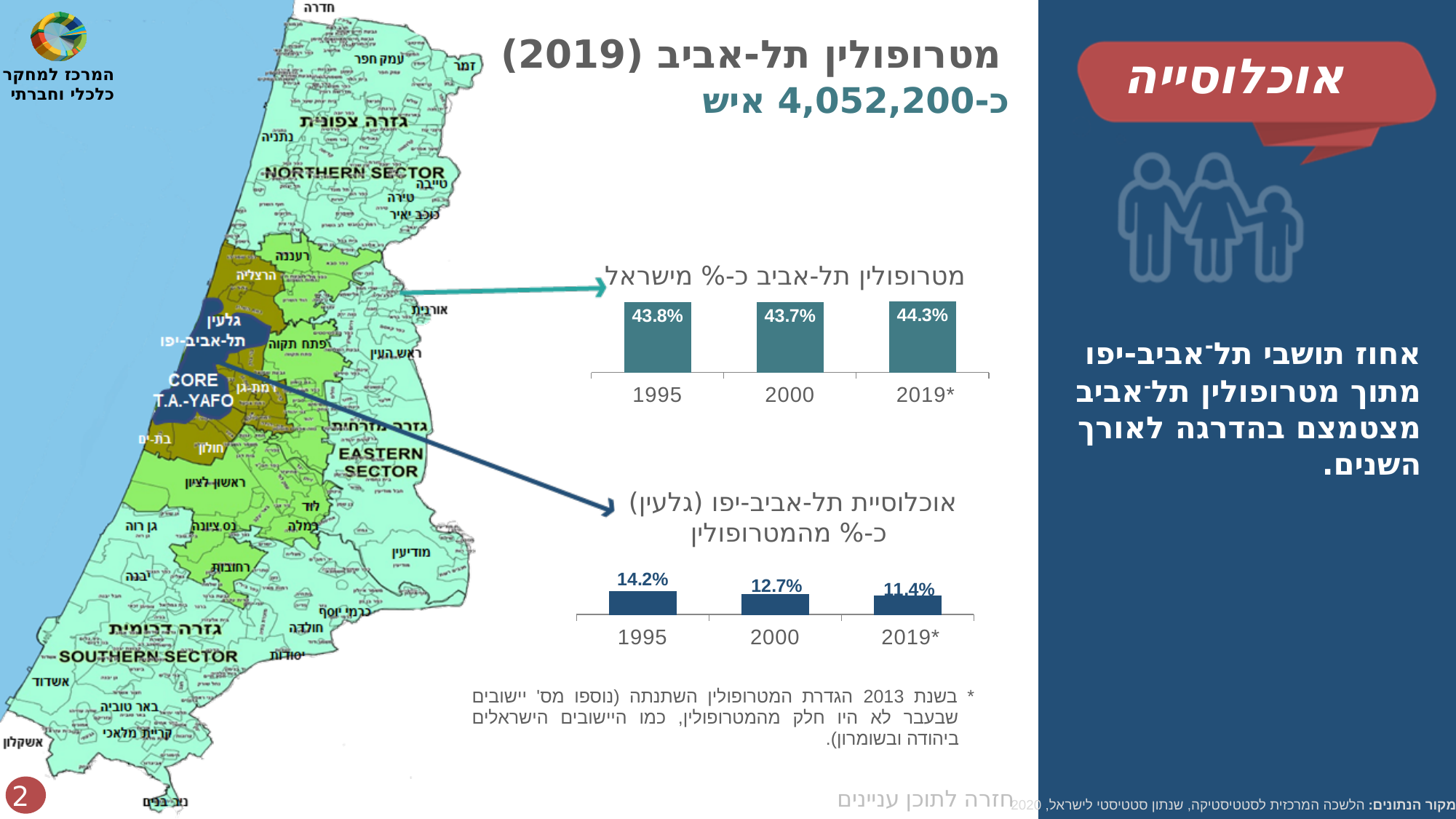
In the bottom chart (Tel Aviv-Yafo core as % of the metropolis), what is the value for 1995? 14.2% How many bars does the top chart (Tel Aviv metropolis as % of Israel) have? 3 In the bottom chart (Tel Aviv-Yafo core as % of the metropolis), what is the difference between the 1995 value and the 2019* value? 2.8% In the top chart (Tel Aviv metropolis as % of Israel), what is the value for 2019*? 44.3% In the bottom chart (Tel Aviv-Yafo core as % of the metropolis), do the values rise or fall from 1995 to 2019*? fall In the bottom chart (Tel Aviv-Yafo core as % of the metropolis), what is the value for 2019*? 11.4% What type of chart is the bottom chart (Tel Aviv-Yafo core as % of the metropolis)? bar chart In the top chart (Tel Aviv metropolis as % of Israel), what is the difference between the 2019* value and the 2000 value? 0.6% In the bottom chart (Tel Aviv-Yafo core as % of the metropolis), which year has the highest value? 1995 In the top chart (Tel Aviv metropolis as % of Israel), what is the value for 1995? 43.8% In the top chart (Tel Aviv metropolis as % of Israel), which year has the lowest value? 2000 In the bottom chart (Tel Aviv-Yafo core as % of the metropolis), what is the value for 2000? 12.7%